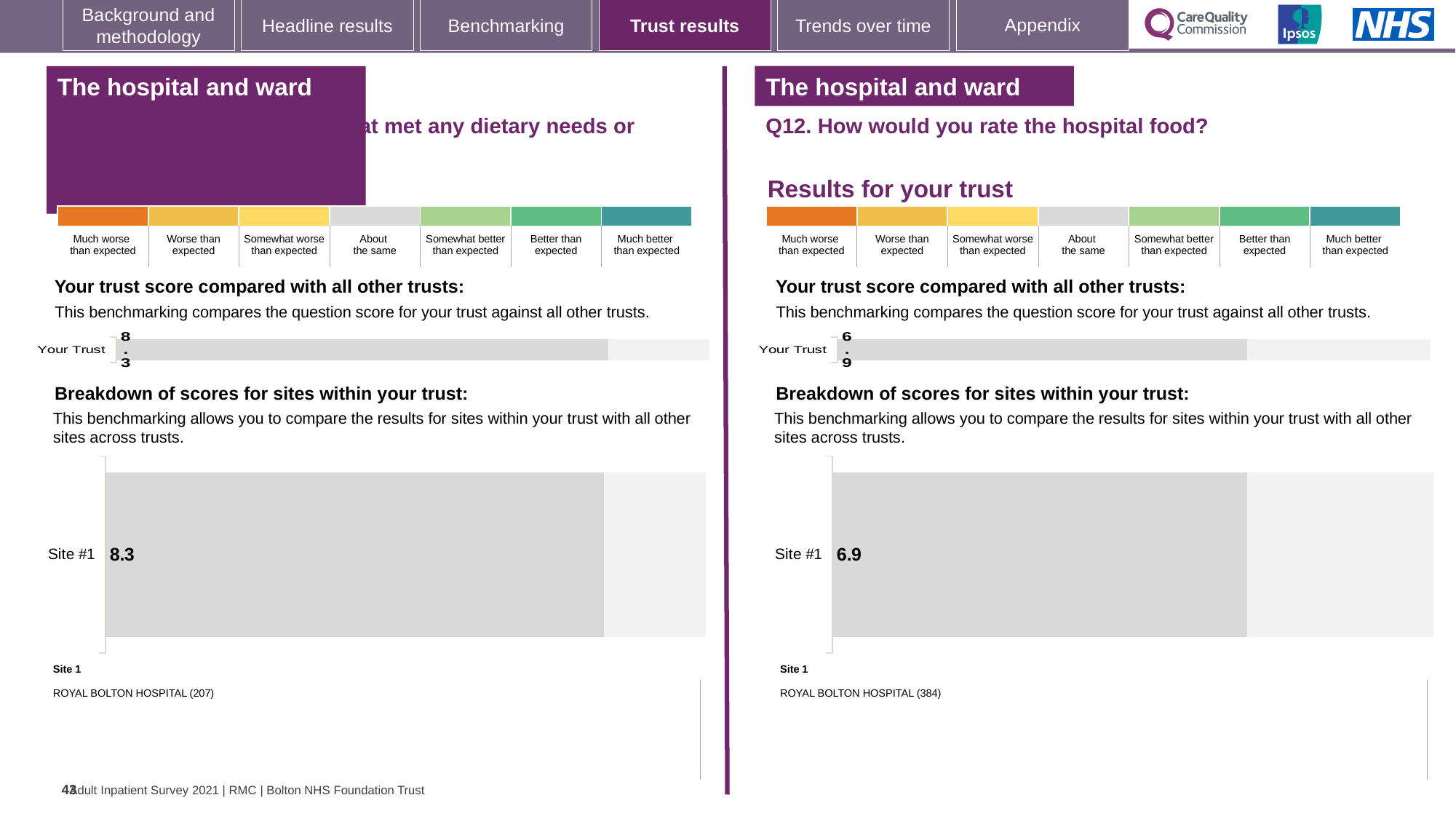
On the right-hand chart for Q12 (How would you rate the hospital food?), what is the score shown for Your Trust? 6.9 On the left-hand chart, what is the score shown for Site #1? 8.3 How many sites are shown in the breakdown of scores on the left-hand chart? 1 On the left-hand chart, what is the score shown for Your Trust? 8.3 On the right-hand chart for Q12, what is the score shown for Site #1? 6.9 What type of chart is used to show the Site #1 score on the right-hand chart for Q12? Bar chart Which is larger: the Site #1 score on the left-hand chart or the Site #1 score on the right-hand chart for Q12? Left-hand chart (8.3) On the left-hand chart, which site is listed as Site 1? ROYAL BOLTON HOSPITAL (207) Is the Your Trust score on the right-hand chart for Q12 the same as its Site #1 score? Yes How many sites are shown in the breakdown of scores on the right-hand chart for Q12? 1 On the right-hand chart for Q12, which site is listed as Site 1? ROYAL BOLTON HOSPITAL (384) What is the difference between the Site #1 score on the left-hand chart and the Site #1 score on the right-hand chart for Q12? 1.4